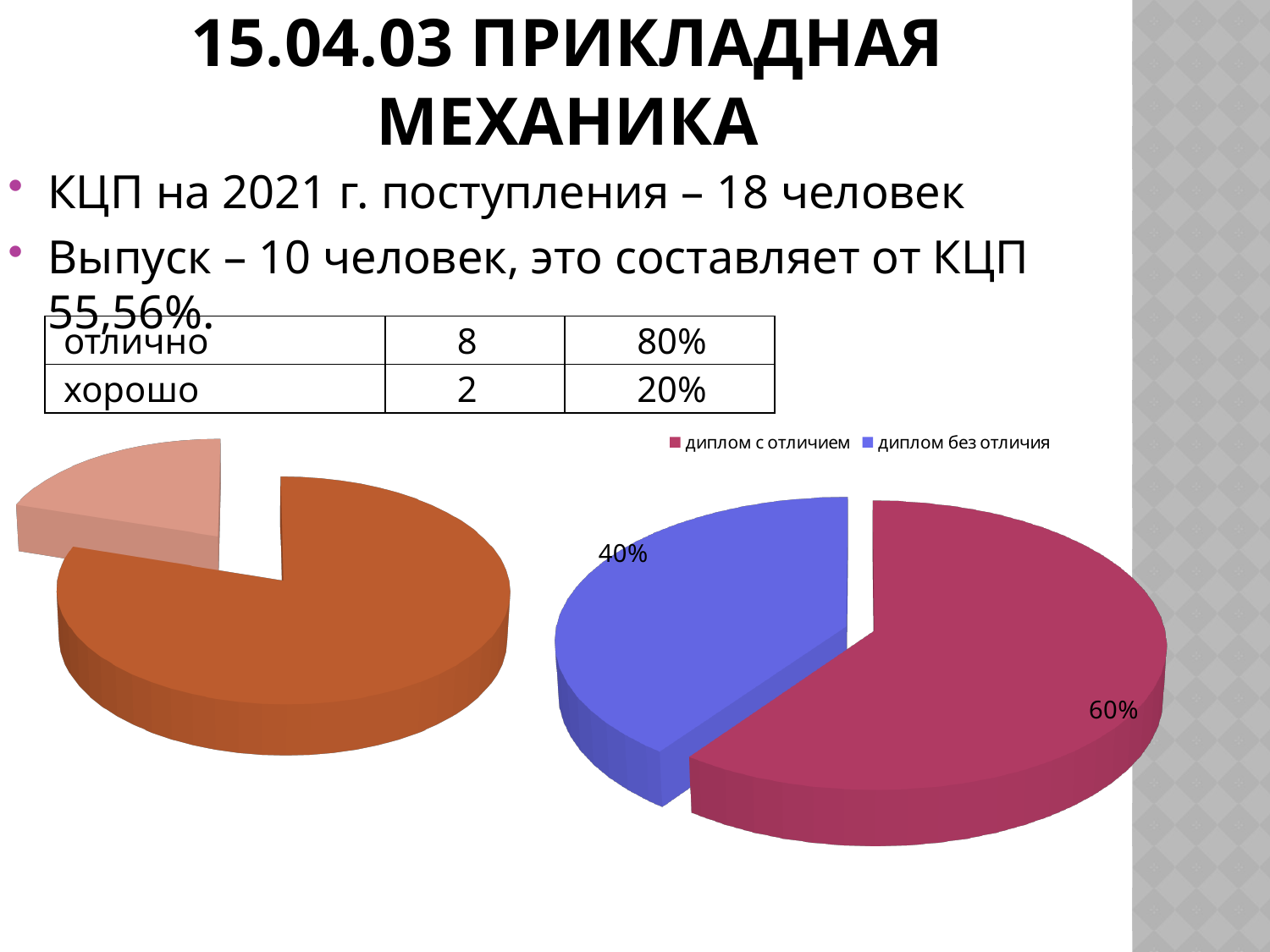
On the right-hand chart, what colour is the slice for 'диплом без отличия'? blue What kind of chart is the right-hand chart? pie chart On the right-hand chart, which category has the largest slice? диплом с отличием On the right-hand chart, what share is shown for 'диплом с отличием'? 60% What kind of chart is the left-hand chart? pie chart On the right-hand chart, what share is shown for 'диплом без отличия'? 40% How many slices does the right-hand chart have? 2 How many slices does the left-hand chart have? 2 On the right-hand chart, which category has the smallest slice? диплом без отличия How many entries does the legend of the right-hand chart list? 2 On the right-hand chart, which is larger: 'диплом с отличием' or 'диплом без отличия'? диплом с отличием On the right-hand chart, what is the difference in percentage points between 'диплом с отличием' and 'диплом без отличия'? 20%